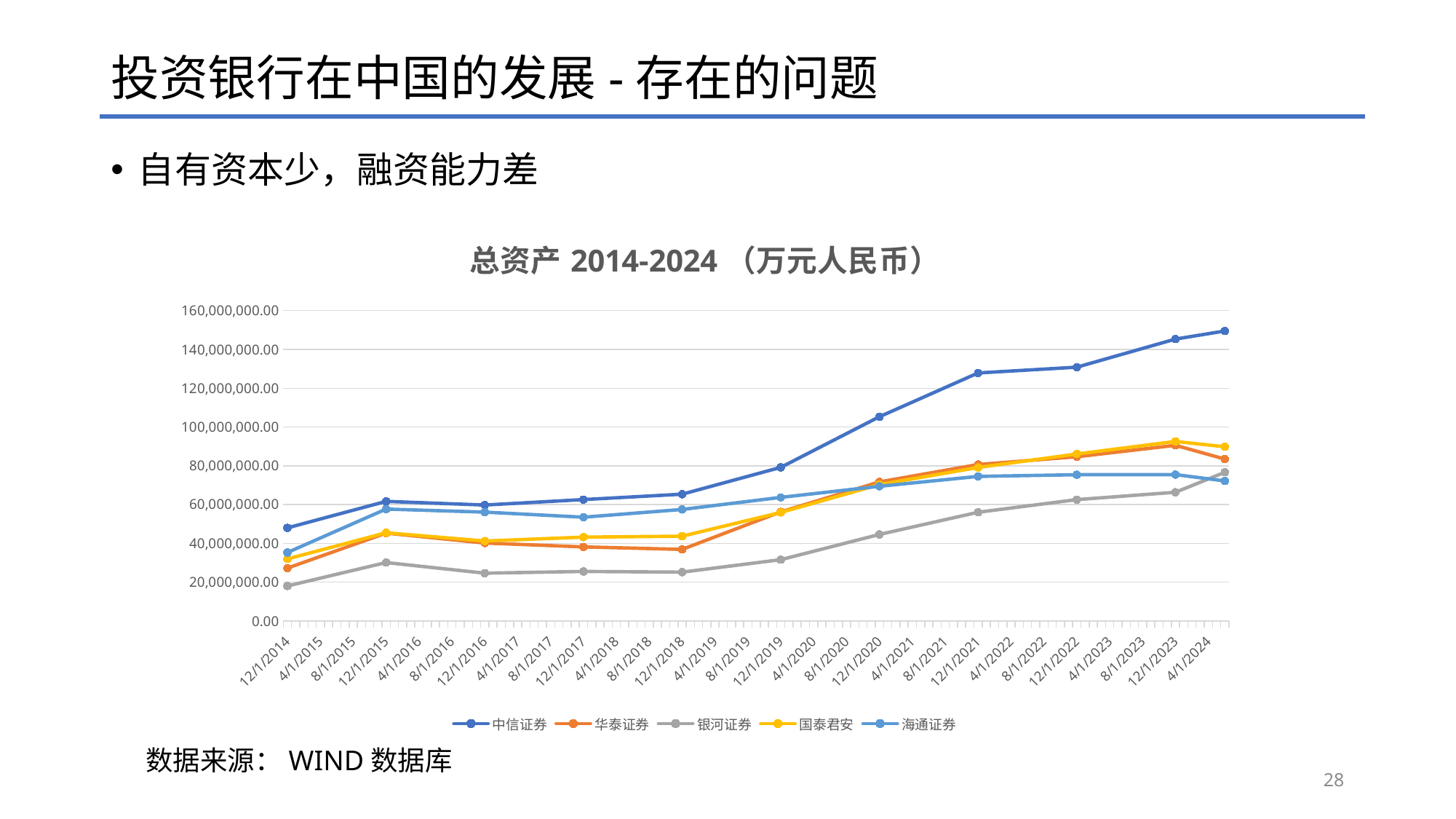
How many series does the legend list? 5 Is the value for 中信证券 at 12/1/2021 greater or less than 120,000,000.00? greater What is the title of the chart? 总资产 2014-2024 （万元人民币） Which series has the lowest value at 12/1/2014? 银河证券 Is the value for 中信证券 at 4/1/2024 greater or less than 140,000,000.00? greater Is the value for 银河证券 at 12/1/2015 greater or less than 40,000,000.00? less Does the value for 中信证券 generally rise or fall from 12/1/2014 to 4/1/2024? rise Which series has the highest value at 4/1/2024? 中信证券 What kind of chart is shown on the slide? line chart At 4/1/2024, which is larger: the value for 国泰君安 or the value for 海通证券? 国泰君安 Which series has the highest value at 12/1/2014? 中信证券